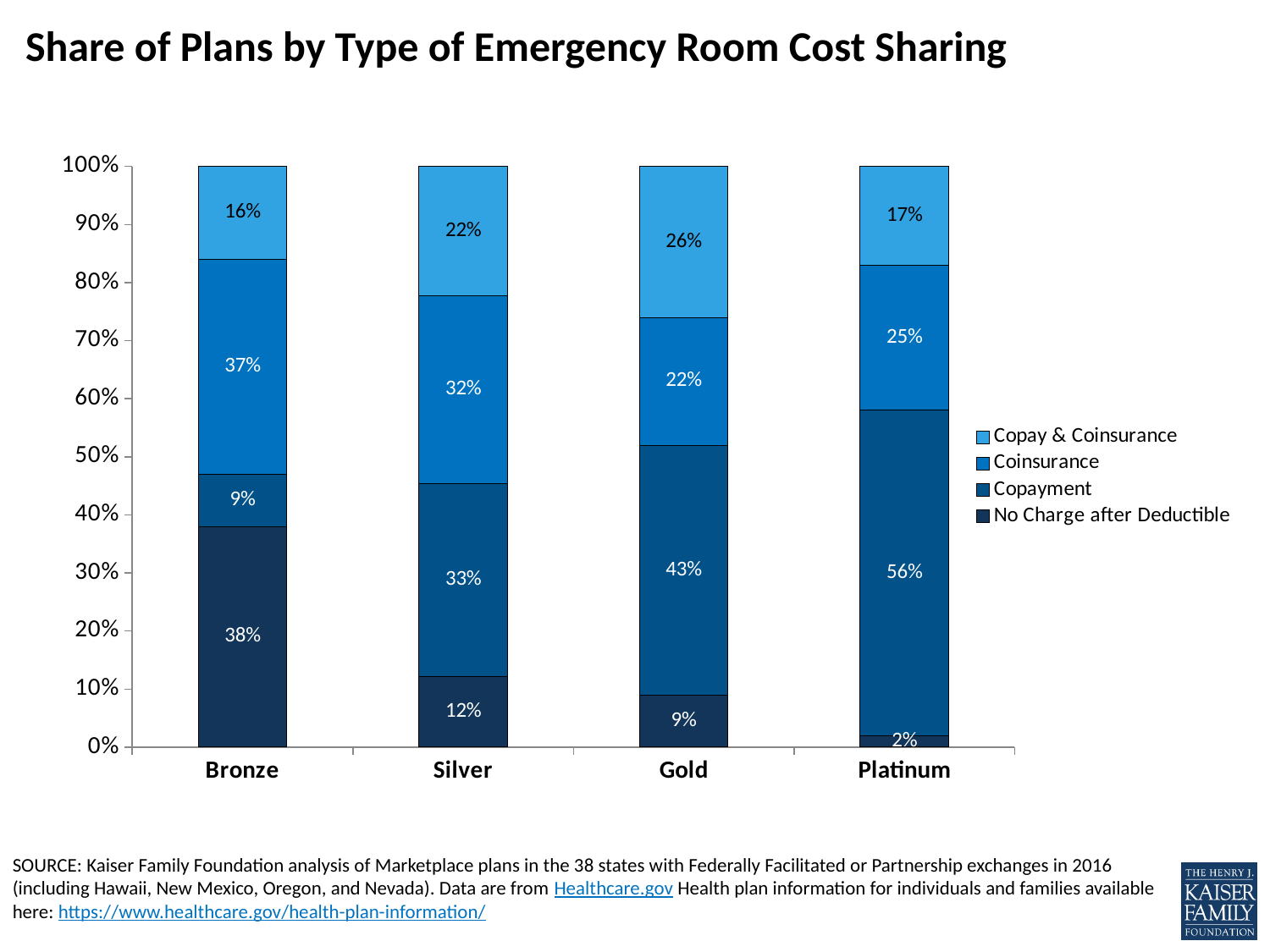
What share of Platinum plans have a Copayment for emergency room cost sharing? 56% Which plan type has the highest share of plans with No Charge after Deductible? Bronze What share of Bronze plans have No Charge after Deductible? 38% Does the share of plans with No Charge after Deductible rise or fall from Bronze to Platinum? Fall Which plan type has the lowest share of plans with a Copayment? Bronze What share of Silver plans have Coinsurance? 32% What kind of chart is shown on the slide? Stacked bar chart What share of Gold plans have Copay & Coinsurance? 26% Which is larger: the Coinsurance share for Bronze or for Platinum? Bronze What is the difference between the Copayment share for Platinum and for Gold? 13% How many plan types are shown on the x axis? 4 How many series does the legend list? 4